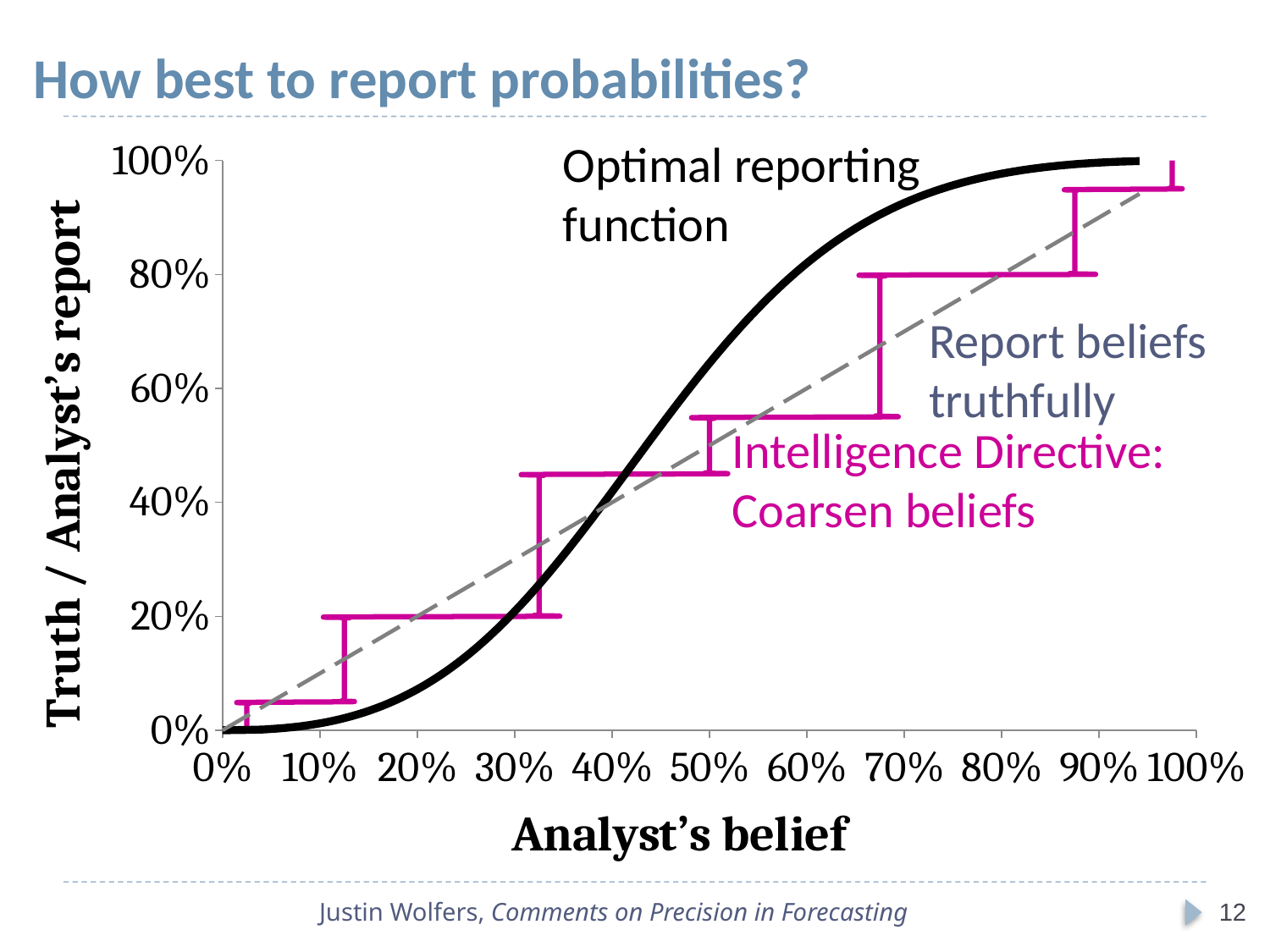
What is the title of the x axis? Analyst's belief At an analyst's belief of 70%, which line is higher: the Optimal reporting function or the Report beliefs truthfully line? Optimal reporting function At an analyst's belief of 30%, which line is higher: the Optimal reporting function or the Report beliefs truthfully line? Report beliefs truthfully What report does the Intelligence Directive: Coarsen beliefs line give for an analyst's belief of 20%? 20% How many labelled lines (series) are plotted on the chart? 3 What is the title of the y axis? Truth / Analyst's report Does the Optimal reporting function rise or fall as the analyst's belief increases? rises What report does the Intelligence Directive: Coarsen beliefs line give for an analyst's belief of 80%? 80% What kind of chart is shown on the slide? line chart Is the value of the Optimal reporting function at an analyst's belief of 20% greater or less than 20%? less Is the value of the Optimal reporting function at an analyst's belief of 70% greater or less than 80%? greater What is the highest value shown on the y axis? 100%